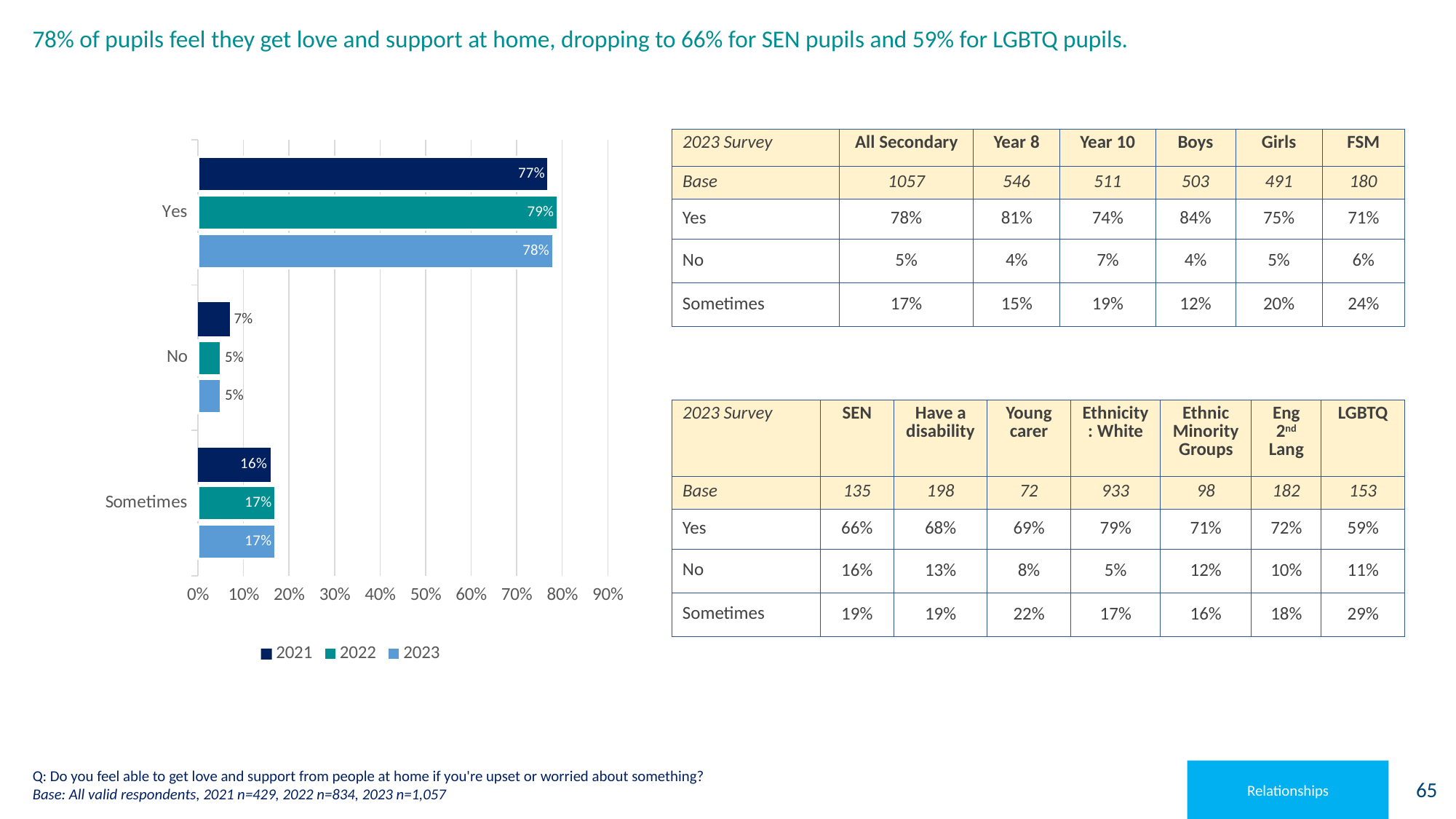
What is the difference between the 'Yes' values for 2022 and 2021? 2% What is the value for 'Sometimes' in 2022? 17% How many response categories are shown on the y axis? 3 Which response category has the lowest values across all years? No Is the value for 'Yes' in 2021 greater or less than 70%? greater Is the 2021 value for 'Sometimes' larger or smaller than the 2023 value for 'Sometimes'? smaller Which series is shown in the darkest blue colour? 2021 What is the value for 'No' in 2021? 7% What kind of chart is shown on the slide? bar chart What is the value for 'Yes' in 2023? 78% How many series does the legend list? 3 Which year has the highest value for 'Yes'? 2022